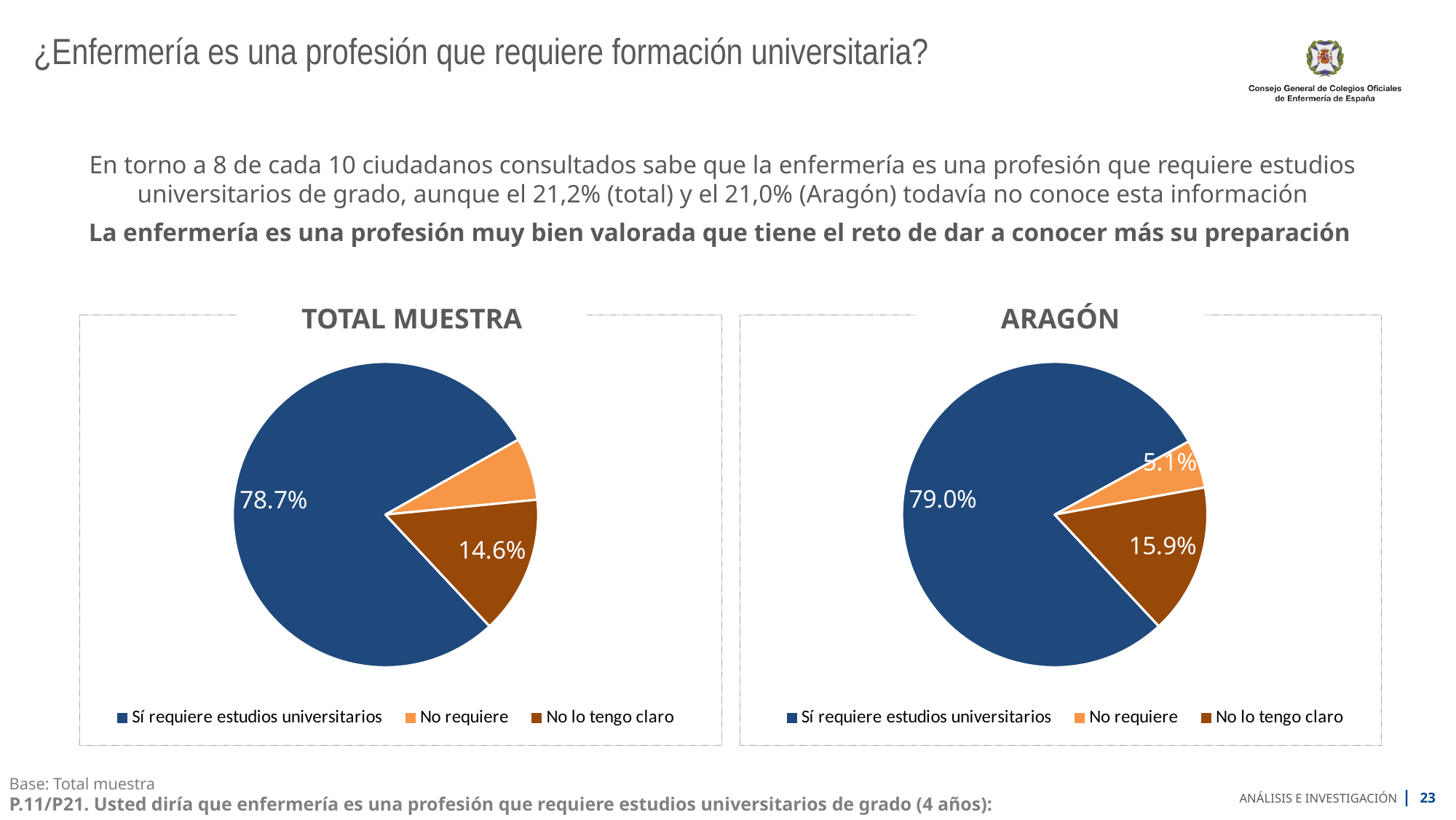
In the TOTAL MUESTRA pie chart, what percentage corresponds to "Sí requiere estudios universitarios"? 78.7% In the TOTAL MUESTRA pie chart, what percentage corresponds to "No lo tengo claro"? 14.6% In the ARAGÓN pie chart, what percentage corresponds to "No lo tengo claro"? 15.9% In the ARAGÓN pie chart, which category has the largest slice? Sí requiere estudios universitarios In the ARAGÓN pie chart, what percentage corresponds to "No requiere"? 5.1% In the TOTAL MUESTRA pie chart, which category has the smallest slice? No requiere In the ARAGÓN pie chart, what is the difference between "No lo tengo claro" and "No requiere"? 10.8% In the ARAGÓN pie chart, which category has the smallest slice? No requiere In the ARAGÓN pie chart, what is the difference between "Sí requiere estudios universitarios" and "No lo tengo claro"? 63.1% What type of chart is used for ARAGÓN? Pie chart Which chart shows a larger share for "Sí requiere estudios universitarios", TOTAL MUESTRA or ARAGÓN? ARAGÓN How many categories does the legend of the TOTAL MUESTRA chart list? 3